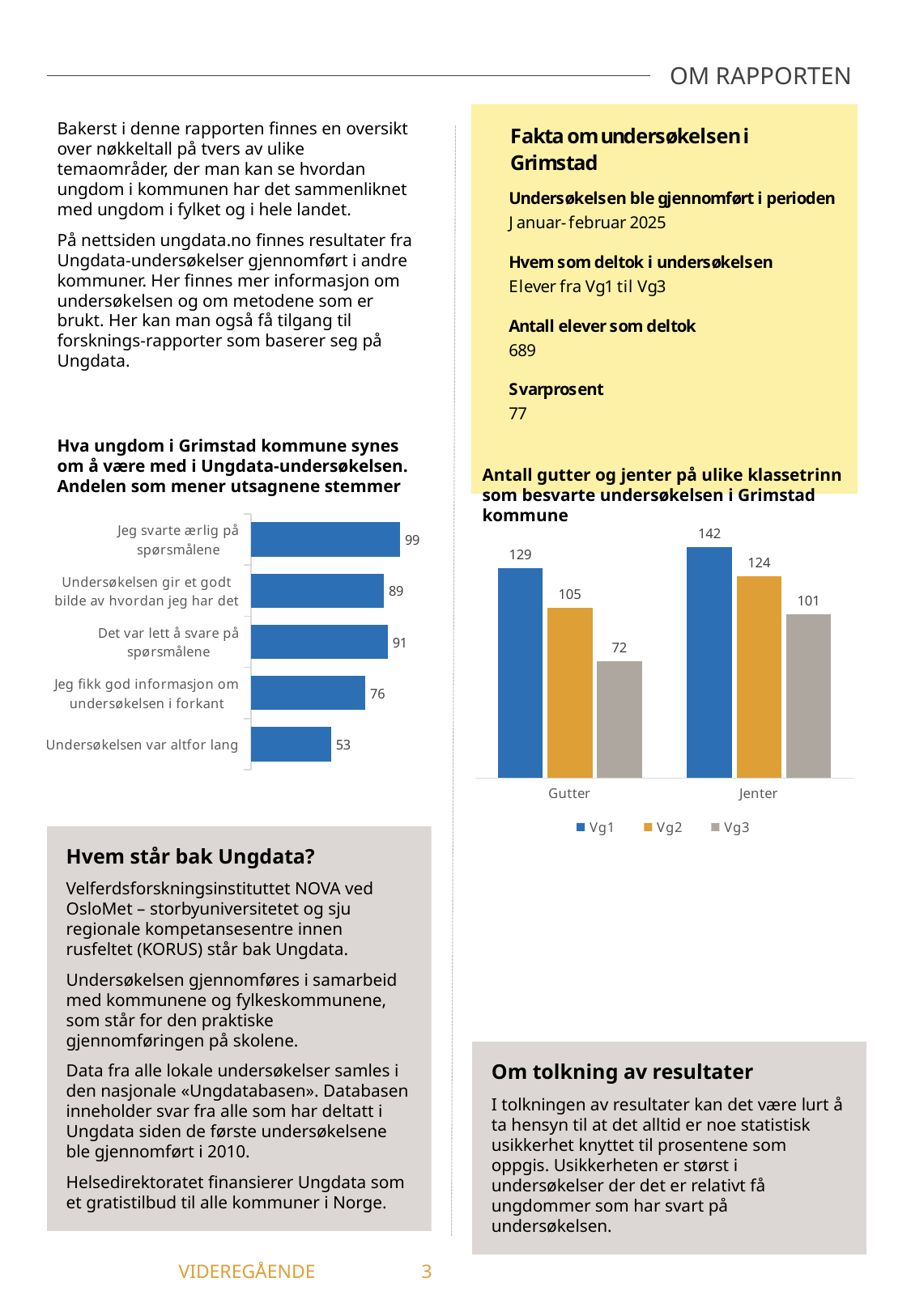
In the chart "Antall gutter og jenter på ulike klassetrinn som besvarte undersøkelsen i Grimstad kommune", what is the difference between Vg2 for Jenter and Vg2 for Gutter? 19 In the chart "Antall gutter og jenter på ulike klassetrinn som besvarte undersøkelsen i Grimstad kommune", which is larger: Vg3 for Gutter or Vg3 for Jenter? Vg3 for Jenter In the chart "Antall gutter og jenter på ulike klassetrinn som besvarte undersøkelsen i Grimstad kommune", which bar has the highest value? Vg1 among Jenter (142) In the left chart about what youth in Grimstad think of participating in the Ungdata survey, how many statements are shown? 5 In the chart "Antall gutter og jenter på ulike klassetrinn som besvarte undersøkelsen i Grimstad kommune", what is the value for Vg1 among Gutter? 129 In the left chart about what youth in Grimstad think of participating in the Ungdata survey, what is the value for "Jeg svarte ærlig på spørsmålene"? 99 In the left chart about what youth in Grimstad think of participating in the Ungdata survey, what is the value for "Undersøkelsen var altfor lang"? 53 In the chart "Antall gutter og jenter på ulike klassetrinn som besvarte undersøkelsen i Grimstad kommune", how many series does the legend list? 3 In the left chart about what youth in Grimstad think of participating in the Ungdata survey, which statement has the lowest value? Undersøkelsen var altfor lang In the chart "Antall gutter og jenter på ulike klassetrinn som besvarte undersøkelsen i Grimstad kommune", what is the value for Vg3 among Jenter? 101 What kind of chart is the left chart about what youth in Grimstad think of participating in the Ungdata survey? Bar chart In the left chart about what youth in Grimstad think of participating in the Ungdata survey, what is the difference between "Det var lett å svare på spørsmålene" and "Jeg fikk god informasjon om undersøkelsen i forkant"? 15